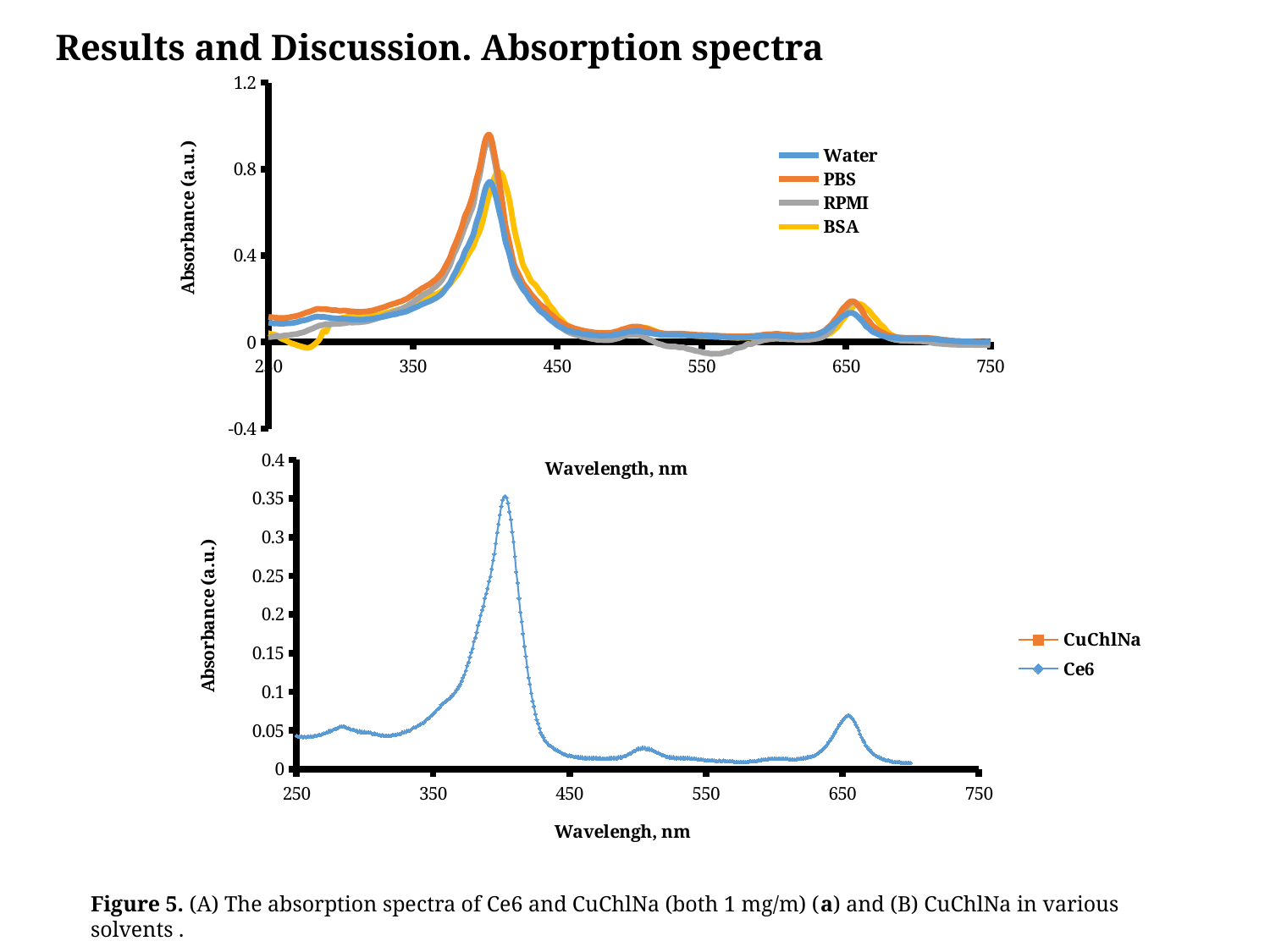
In the top chart, at the main peak near 400 nm, which series reaches a higher absorbance: PBS or Water? PBS In the top chart, is the peak value of the Water series near 400 nm greater or less than 0.4? greater How many series does the legend of the bottom chart list? 2 What is the y-axis title of the bottom chart? Absorbance (a.u.) What kind of chart is the top chart on the slide? line chart In the top chart, is the peak value of the PBS series near 650 nm greater or less than 0.4? less In the bottom chart, is the peak value of the Ce6 series near 400 nm greater or less than 0.3? greater How many series does the legend of the top chart list? 4 In the bottom chart, does the Ce6 series rise or fall between 400 nm and 450 nm? fall Which series in the top chart is drawn in yellow? BSA